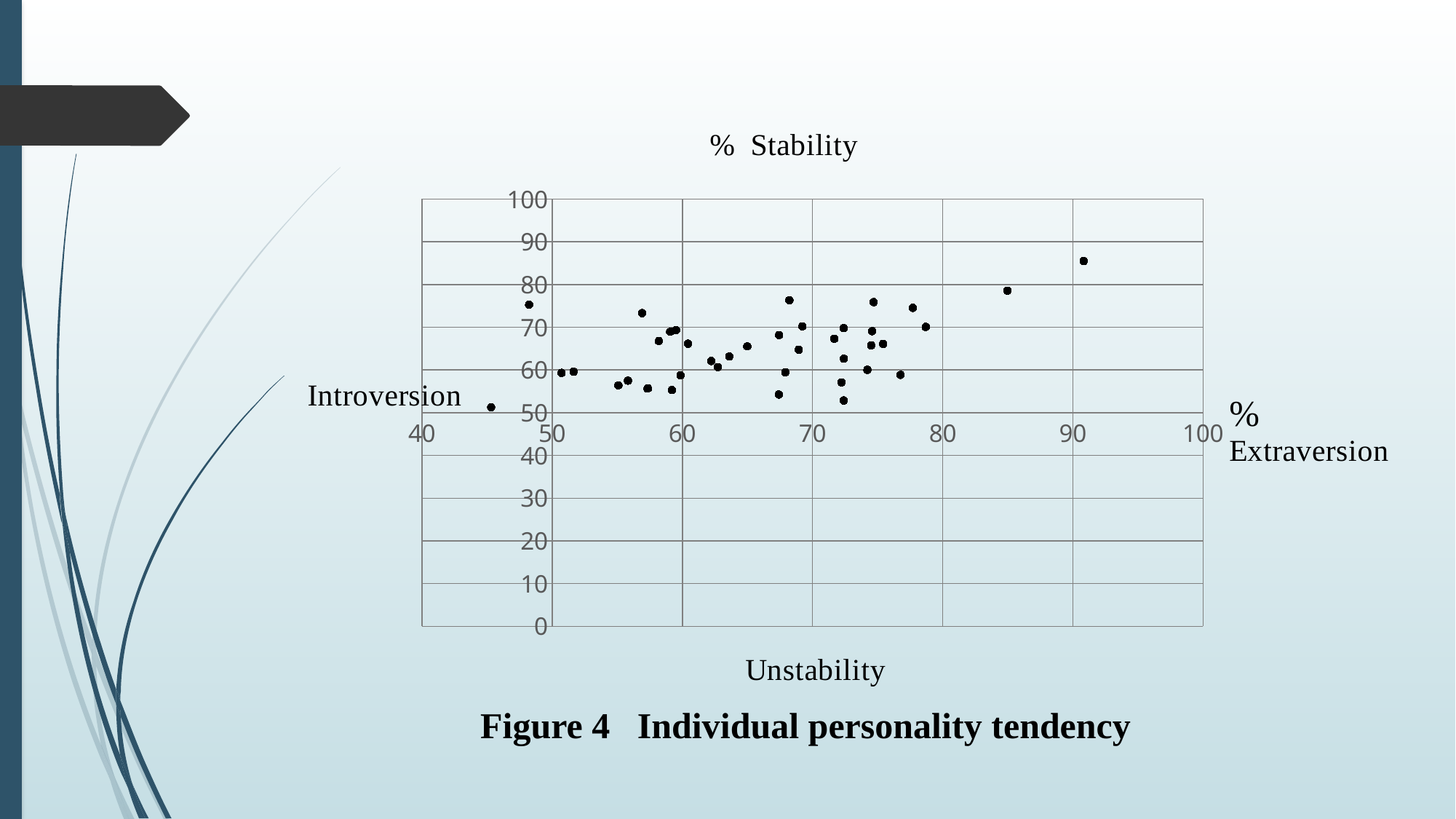
Is the extraversion value of the leftmost point greater or less than 50? less Do the stability values generally rise or fall as extraversion increases along the x axis? rise Is the extraversion value of the rightmost point greater or less than 80? greater What label is shown above the vertical axis of the chart? % Stability Is the highest plotted stability value greater or less than 80? greater What is the caption given for the chart on the slide? Figure 4 Individual personality tendency What kind of chart is shown on the slide? scatter chart What is the highest value shown on the vertical axis? 100